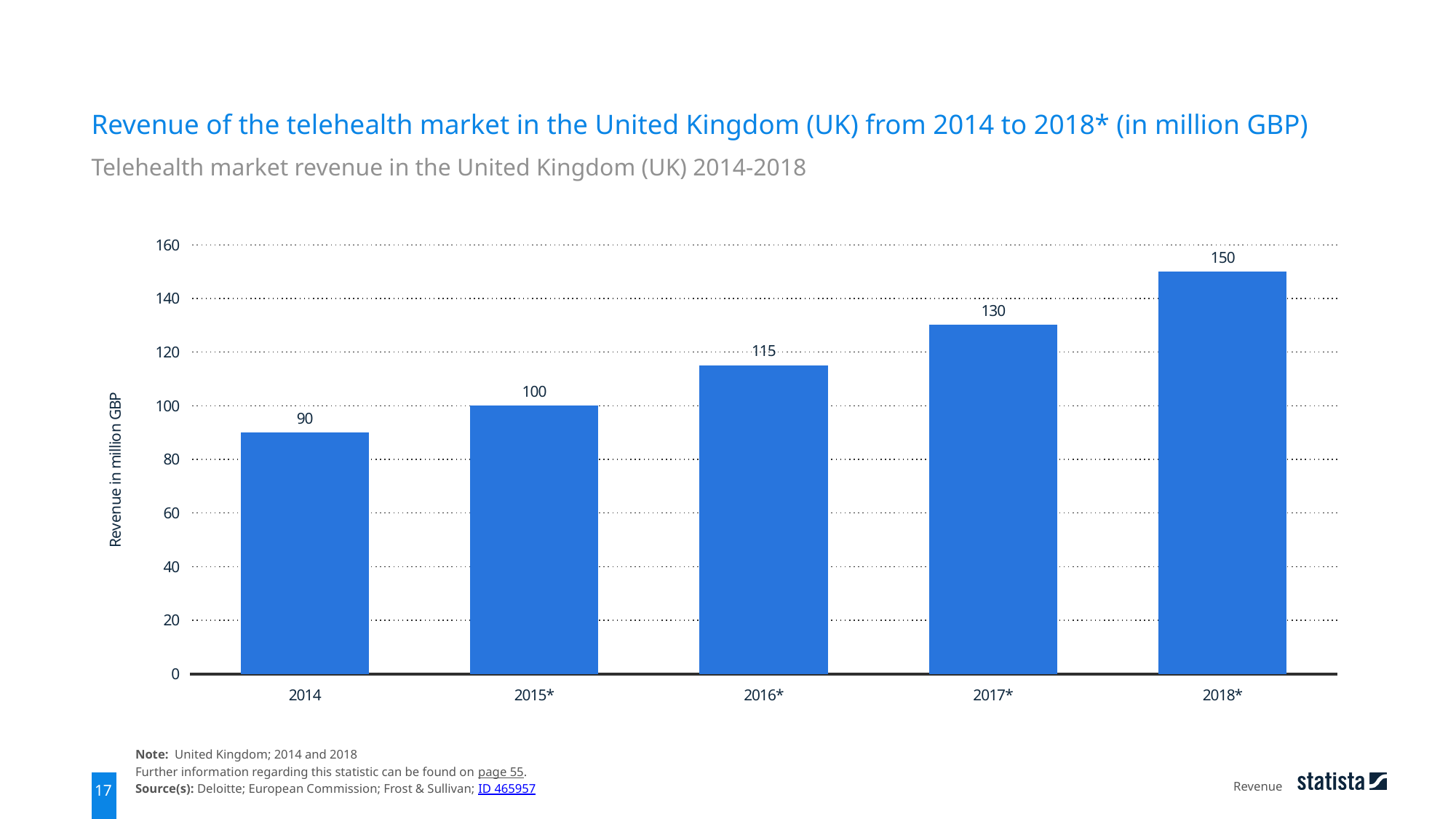
Do the revenue values rise or fall from 2014 to 2018*? Rise Which year has higher revenue, 2015* or 2017*? 2017* What is the telehealth market revenue for 2018*? 150 Is the value for 2017* greater or less than 120? greater What kind of chart is shown on the slide? Bar chart What is the difference in revenue between 2018* and 2014? 60 How many years are shown on the chart? 5 What is the telehealth market revenue for 2014? 90 What is the telehealth market revenue for 2016*? 115 What is the difference in revenue between 2017* and 2016*? 15 Which year has the highest telehealth market revenue? 2018* Which year has the lowest telehealth market revenue? 2014